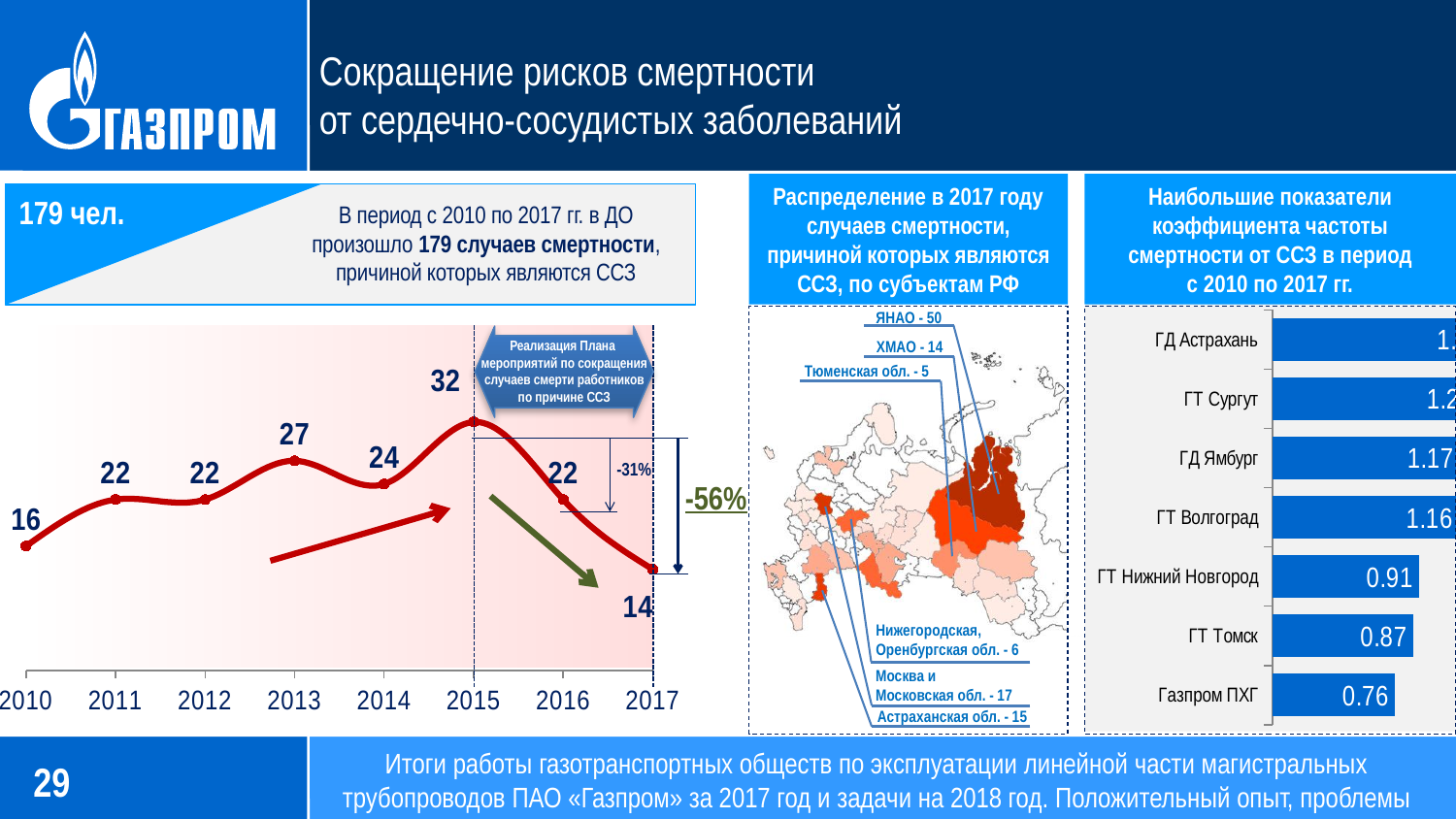
What kind of chart is shown on the right side of the slide? bar chart On the right bar chart, which category has the lowest value? Газпром ПХГ On the left line chart, what is the value for 2015? 32 On the left line chart, which year has the lowest value? 2017 On the left line chart, which is larger, the value for 2013 or the value for 2014? 2013 On the left line chart, which year has the highest value? 2015 On the left line chart, what is the value for 2017? 14 On the right bar chart, what is the value for ГТ Волгоград? 1.16 On the left line chart, what is the difference between the values for 2015 and 2017? 18 On the left line chart, how many years are plotted along the x axis? 8 On the right bar chart, how many categories are shown? 7 On the left line chart, do the values rise or fall from 2015 to 2017? fall